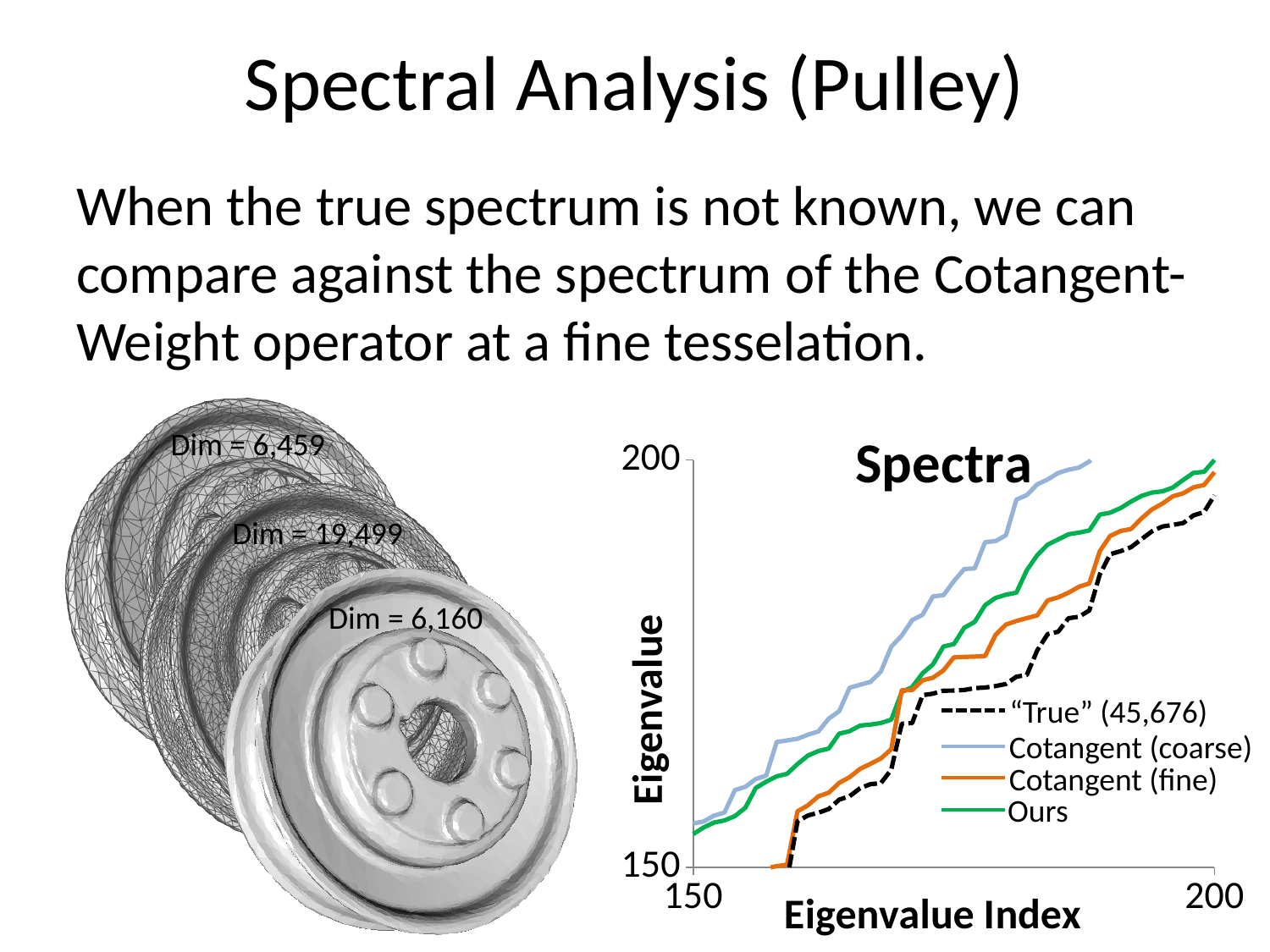
Do the eigenvalues rise or fall as the eigenvalue index increases? rise At eigenvalue index 175, which is larger: Cotangent (coarse) or Ours? Cotangent (coarse) Which series has the lowest eigenvalue at eigenvalue index 200? "True" (45,676) How many series does the chart legend list? 4 What is the highest value shown on the y axis of the chart? 200 Is the value for Cotangent (coarse) at eigenvalue index 150 greater or less than 150? greater What is the label of the x axis of the chart? Eigenvalue Index Which series has the highest eigenvalues across the plotted range? Cotangent (coarse) At eigenvalue index 190, which is larger: Ours or "True" (45,676)? Ours What is the title of the chart? Spectra Is the value for Ours at eigenvalue index 175 greater or less than 200? less What kind of chart is shown on the slide? line chart